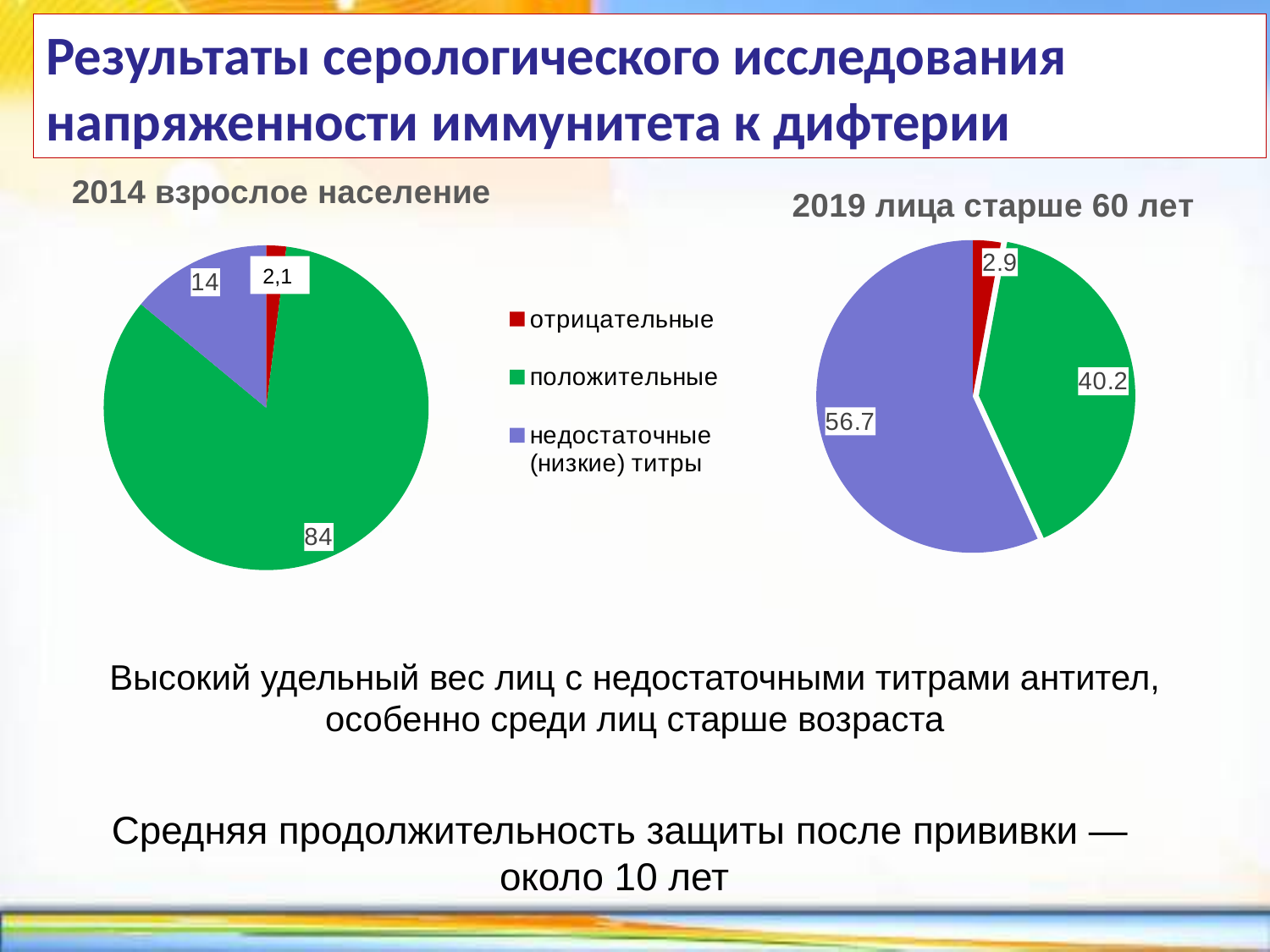
In the '2014 взрослое население' chart, which category has the smallest slice? отрицательные In the '2019 лица старше 60 лет' chart, what is the value for 'положительные'? 40.2 In the '2014 взрослое население' chart, what is the value for 'недостаточные (низкие) титры'? 14 In the '2019 лица старше 60 лет' chart, what is the value for 'отрицательные'? 2.9 Which is larger in the '2014 взрослое население' chart: 'положительные' or 'недостаточные (низкие) титры'? положительные In the '2014 взрослое население' chart, what is the value for 'отрицательные'? 2,1 How many entries does the legend list? 3 In the '2019 лица старше 60 лет' chart, what is the value for 'недостаточные (низкие) титры'? 56.7 What type of chart is used on this slide? pie chart In the '2019 лица старше 60 лет' chart, which category has the largest slice? недостаточные (низкие) титры In the '2019 лица старше 60 лет' chart, what is the difference between 'недостаточные (низкие) титры' and 'положительные'? 16.5 In the '2014 взрослое население' chart, what is the value for 'положительные'? 84